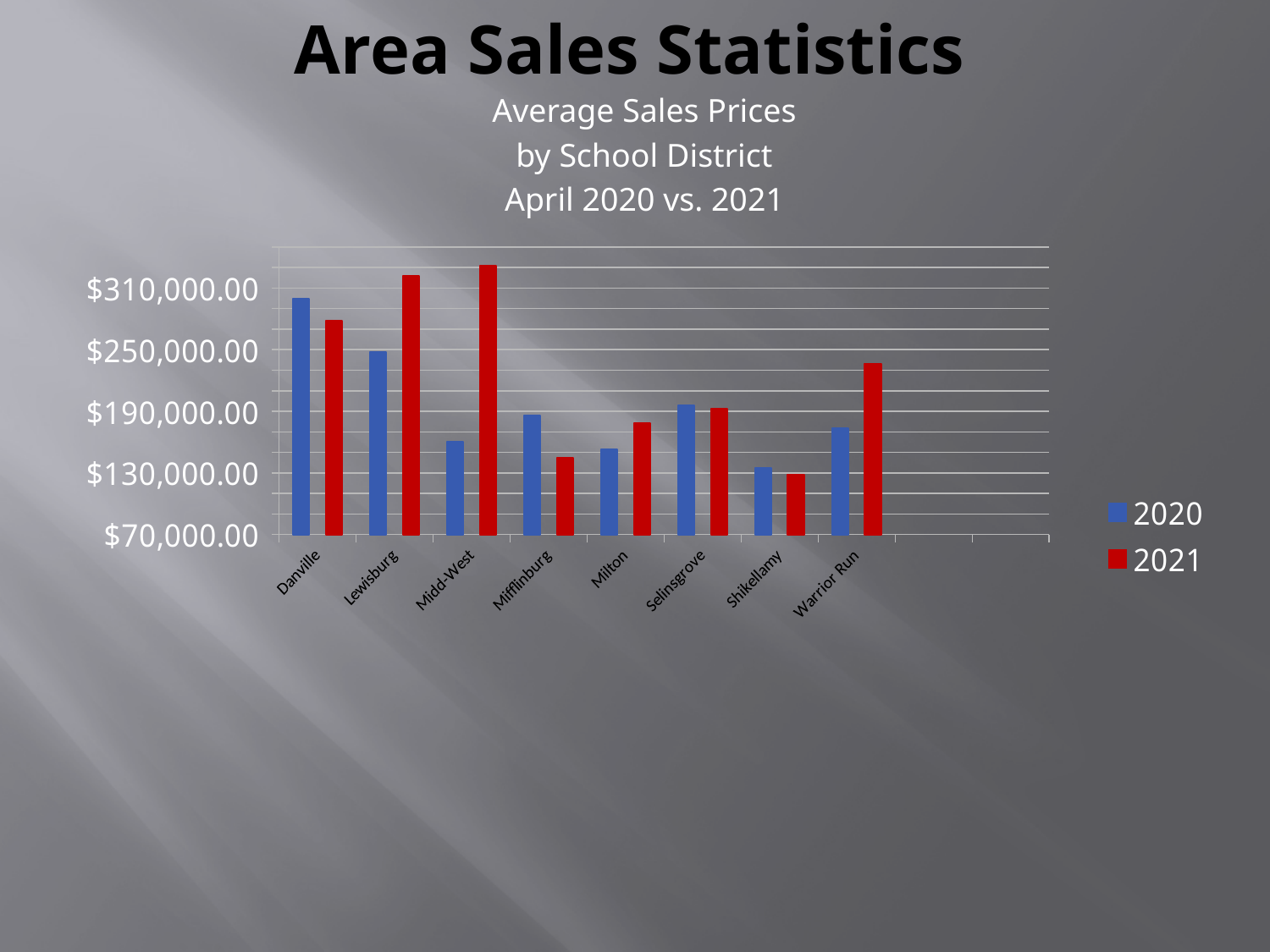
Which school district has the lowest 2020 average sales price? Shikellamy Which school district has the highest 2021 average sales price? Midd-West For Lewisburg, which year has the higher average sales price, 2020 or 2021? 2021 For Mifflinburg, which year has the higher average sales price, 2020 or 2021? 2020 Is the 2020 value for Danville greater or less than $250,000.00? greater Which school district has the highest 2020 average sales price? Danville Which school district has the lowest 2021 average sales price? Shikellamy What kind of chart is shown on the slide? bar chart How many series does the chart's legend list? 2 Is the 2021 value for Midd-West greater or less than $310,000.00? greater How many school districts are shown on the x axis of the chart? 8 Which colour represents the 2021 series in the chart? red